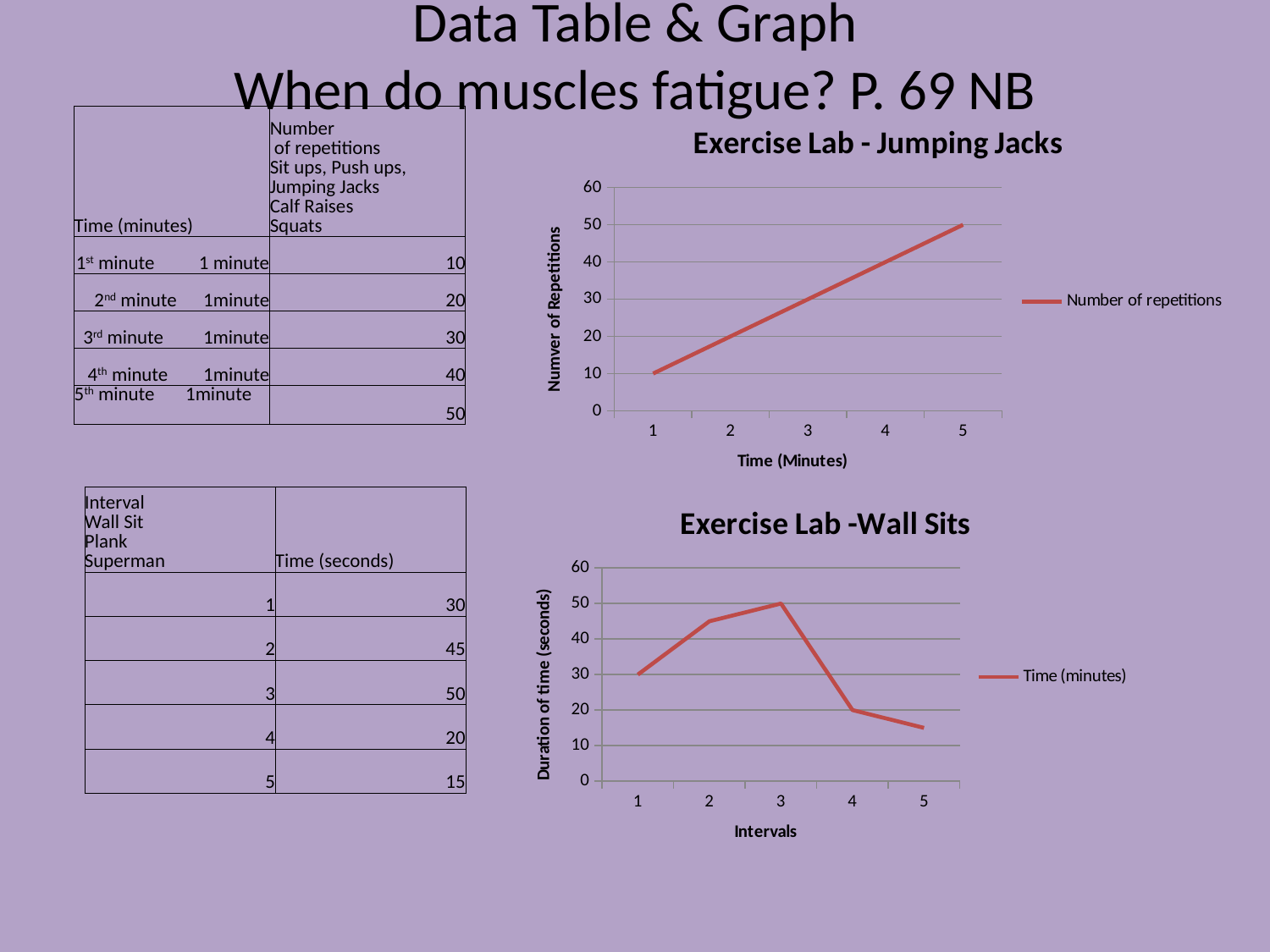
In the 'Exercise Lab -Wall Sits' chart, what is the duration at interval 3? 50 How many time points are plotted in the 'Exercise Lab - Jumping Jacks' chart? 5 What kind of chart is the 'Exercise Lab - Jumping Jacks' chart? line chart In the 'Exercise Lab - Jumping Jacks' chart, what is the number of repetitions at minute 1? 10 In the 'Exercise Lab - Jumping Jacks' chart, do the values rise or fall from minute 1 to minute 5? rise In the 'Exercise Lab - Jumping Jacks' chart, what is the number of repetitions at minute 5? 50 In the 'Exercise Lab -Wall Sits' chart, which is larger, the value at interval 1 or at interval 4? interval 1 In the 'Exercise Lab - Jumping Jacks' chart, what is the difference between the repetitions at minute 5 and at minute 1? 40 What series name does the legend of the 'Exercise Lab -Wall Sits' chart show? Time (minutes) In the 'Exercise Lab -Wall Sits' chart, what is the duration at interval 1? 30 In the 'Exercise Lab -Wall Sits' chart, which interval has the highest duration? 3 In the 'Exercise Lab -Wall Sits' chart, is the value at interval 2 greater or less than 40? greater